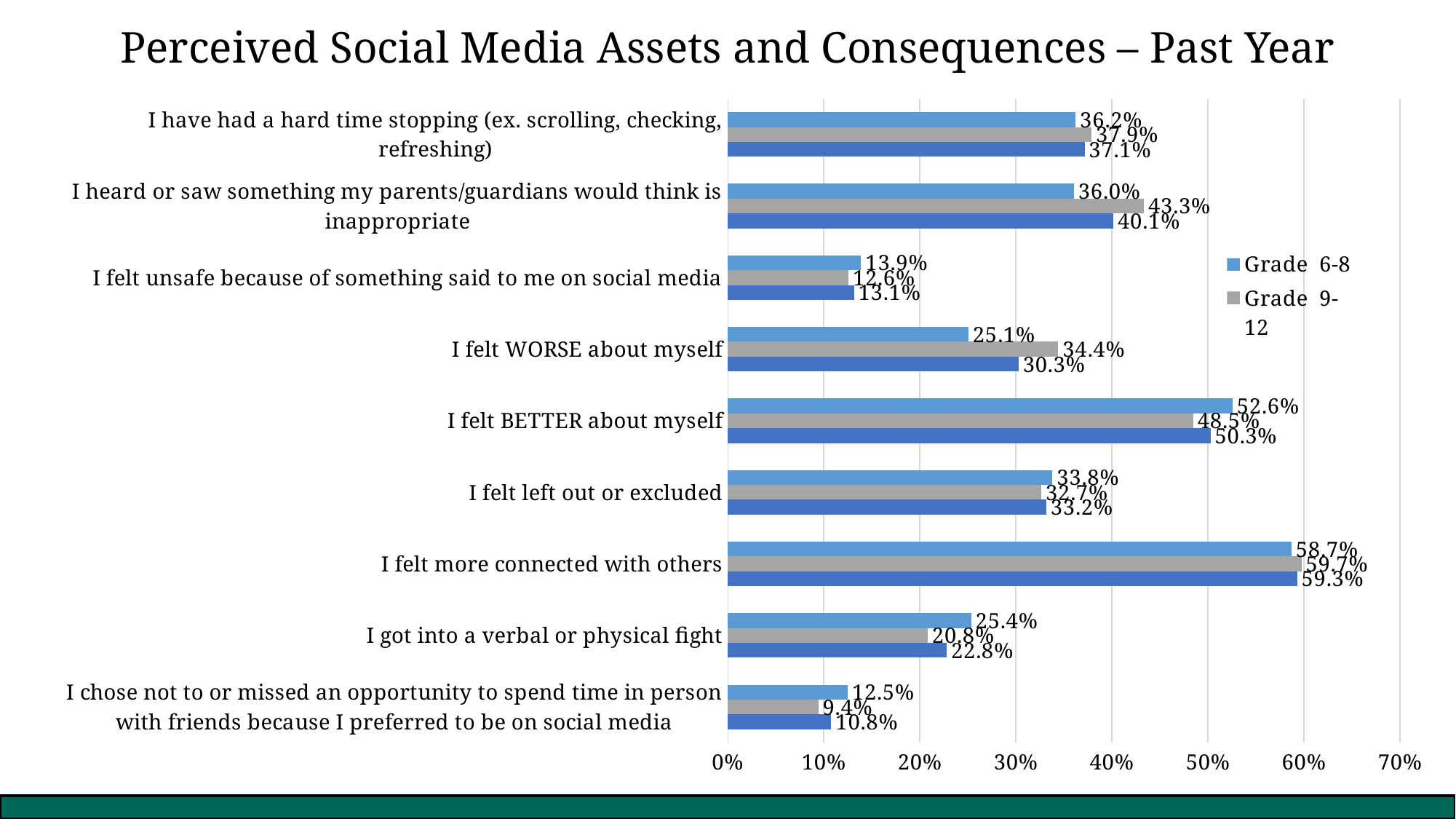
Which category has the lowest Grade 9-12 value? I chose not to or missed an opportunity to spend time in person with friends because I preferred to be on social media Is the Grade 9-12 value for "I felt more connected with others" greater or less than 50%? greater What is the title of the chart? Perceived Social Media Assets and Consequences – Past Year What is the difference between the Grade 9-12 and Grade 6-8 values for "I felt WORSE about myself"? 9.3 percentage points For "I felt BETTER about myself", which is larger: the Grade 6-8 value or the Grade 9-12 value? Grade 6-8 What is the Grade 6-8 value for "I have had a hard time stopping (ex. scrolling, checking, refreshing)"? 36.2% What is the Grade 6-8 value for "I got into a verbal or physical fight"? 25.4% Which category has the highest Grade 6-8 value? I felt more connected with others What kind of chart is shown on the slide? Bar chart What is the Grade 9-12 value for "I heard or saw something my parents/guardians would think is inappropriate"? 43.3% How many categories are shown on the chart? 9 What is the Grade 9-12 value for "I felt WORSE about myself"? 34.4%